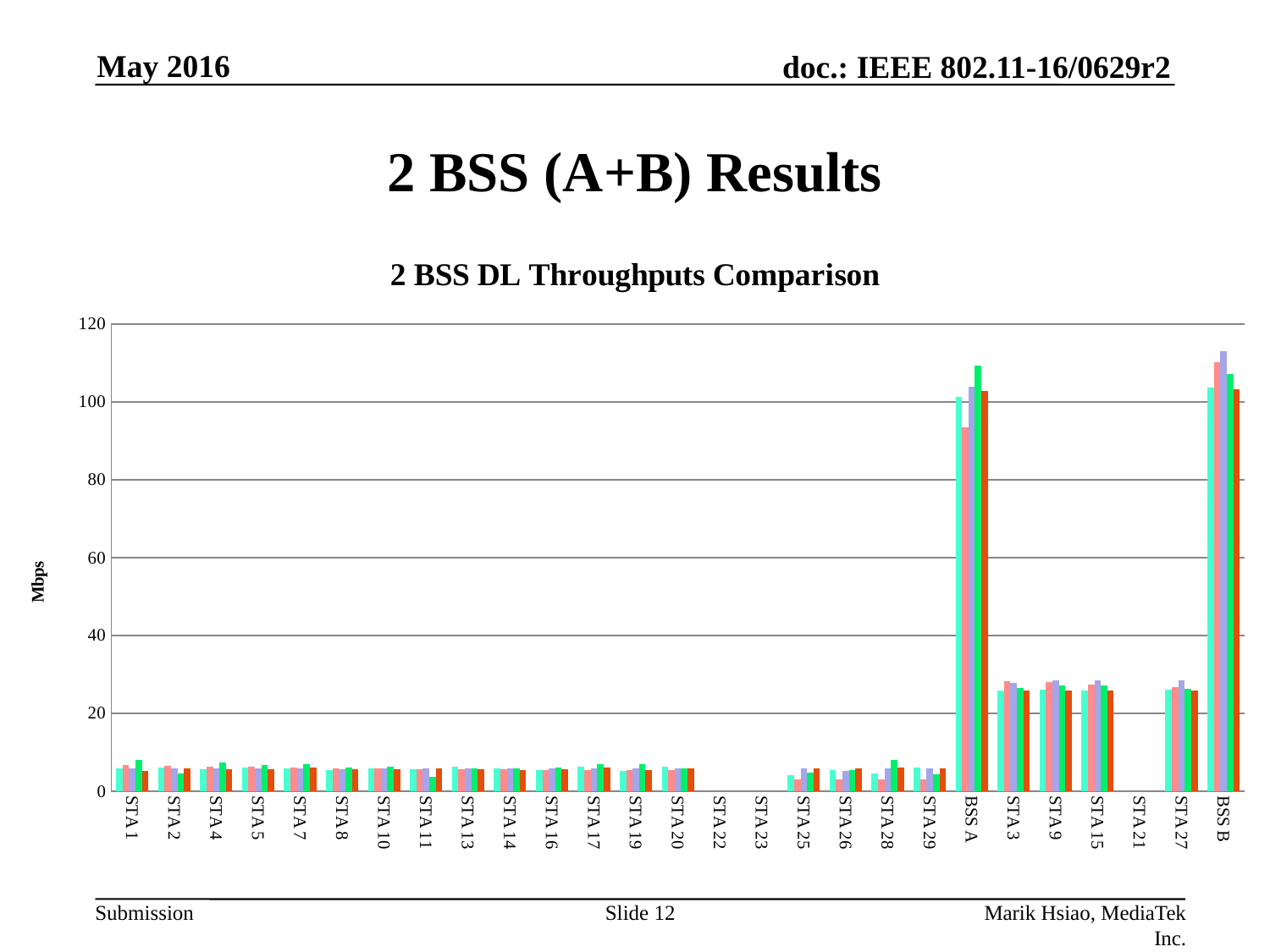
Which has larger values, STA 3 or STA 1? STA 3 What is the title of the chart? 2 BSS DL Throughputs Comparison What kind of chart is shown on the slide? bar chart Which has larger values, BSS A or BSS B? BSS B Are the values for BSS B greater or less than 80? greater What is the label on the vertical axis of the chart? Mbps Which category has the highest bars in the chart? BSS B Are the values for STA 9 greater or less than 20? greater Are the values for STA 1 greater or less than 20? less How many categories are shown along the x axis of the chart? 27